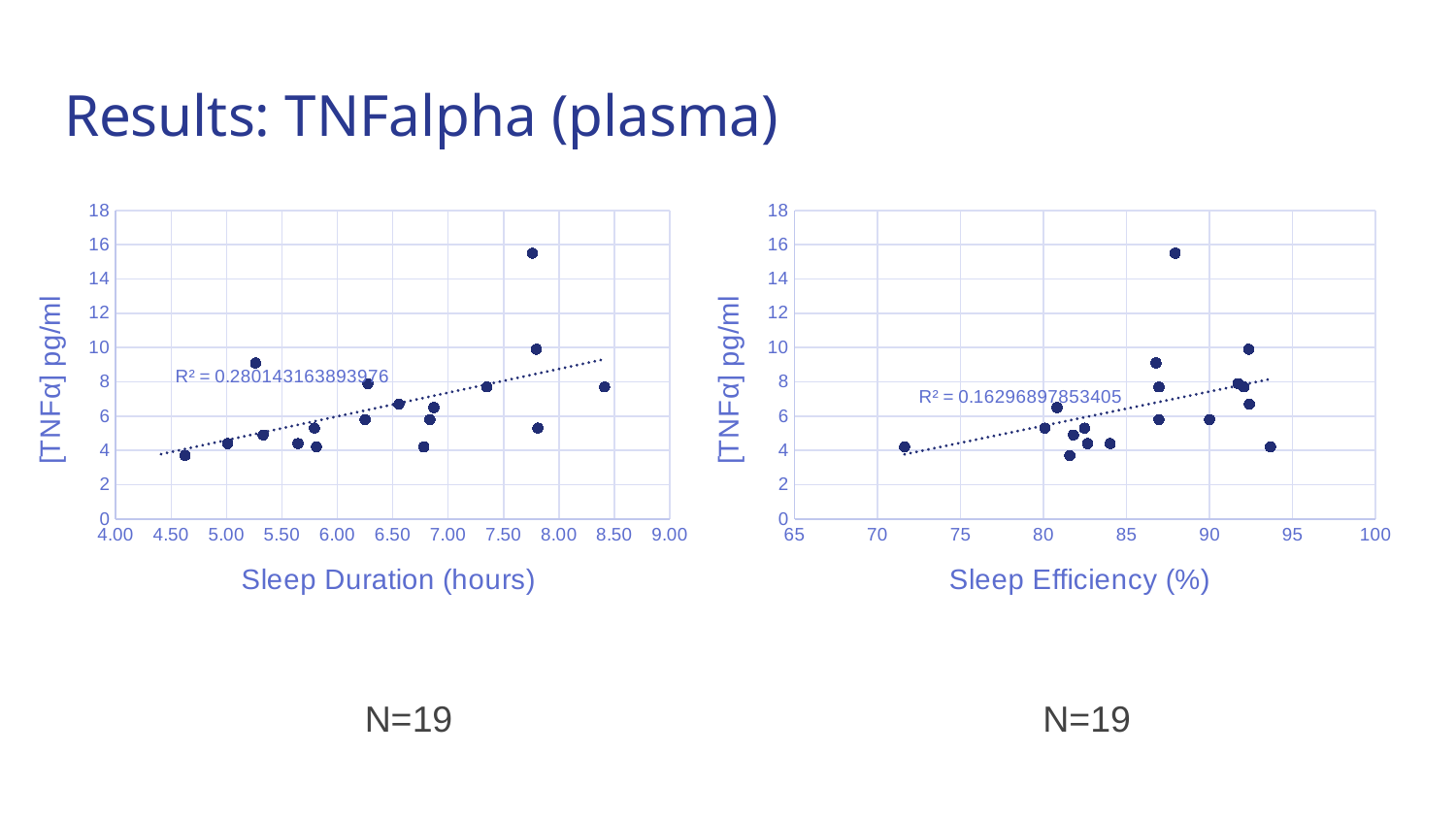
In the right chart (Sleep Efficiency), does the dotted trendline rise or fall as sleep efficiency increases? rise What kind of chart is the left chart (Sleep Duration)? scatter chart In the left chart (Sleep Duration), is the highest plotted TNFα value greater or less than 14? greater What is the x-axis title of the right chart? Sleep Efficiency (%) Which chart has the larger R² value, the left chart (Sleep Duration) or the right chart (Sleep Efficiency)? the left chart (Sleep Duration) In the right chart (Sleep Efficiency), is the TNFα value of the point at about 71.5% sleep efficiency greater or less than 6? less In the left chart (Sleep Duration), what R² value is printed next to the trendline? R² = 0.280143163893976 In the right chart (Sleep Efficiency), what R² value is printed next to the trendline? R² = 0.16296897853405 What kind of chart is the right chart (Sleep Efficiency)? scatter chart What is the y-axis title shared by both charts? [TNFα] pg/ml According to the N label under each chart, how many data points does each chart contain? 19 In the left chart (Sleep Duration), does the dotted trendline rise or fall as sleep duration increases? rise